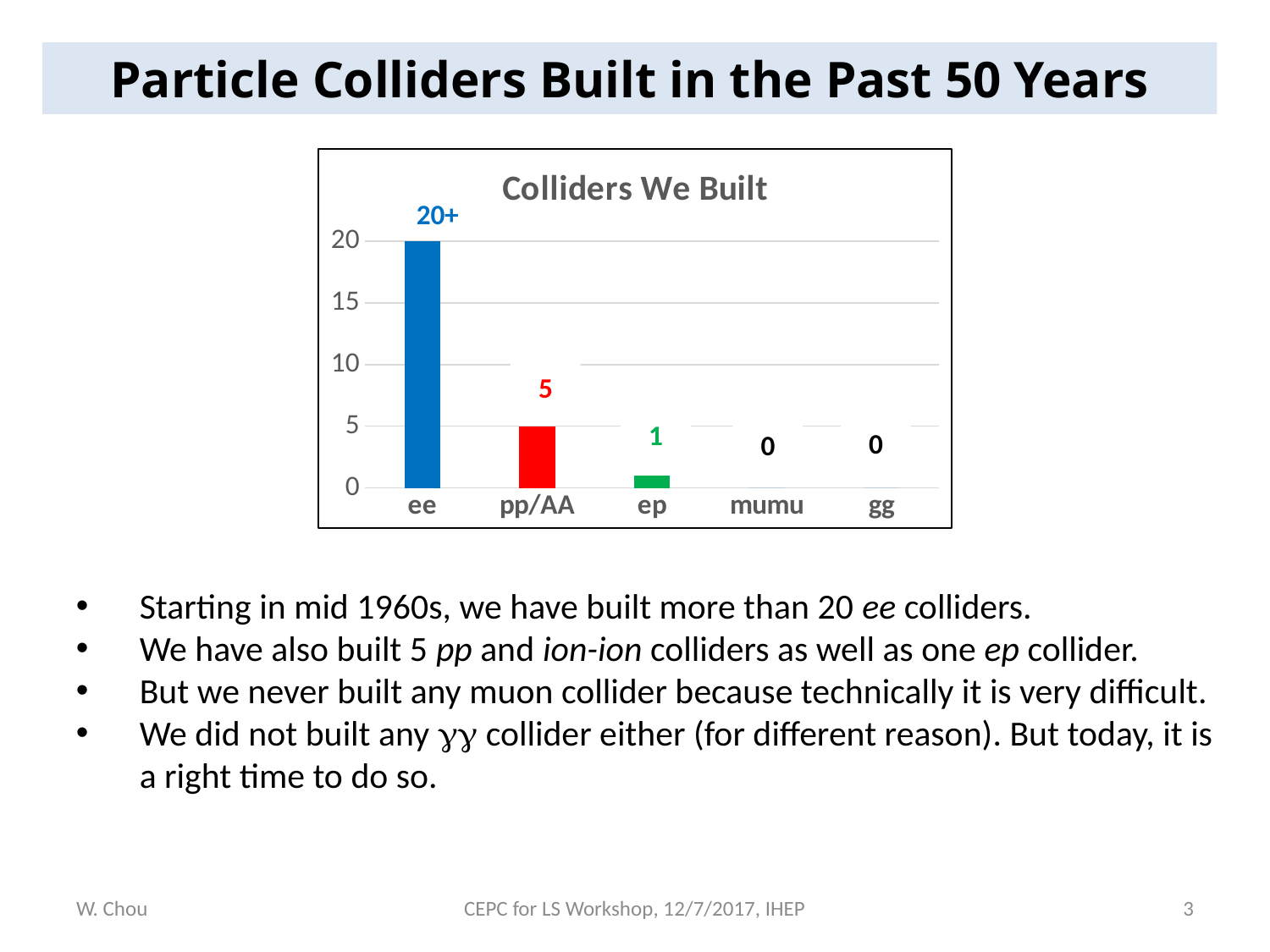
What colour is the pp/AA bar? red What is the title of the chart? Colliders We Built What is the difference between the values for pp/AA and ep? 4 What kind of chart is shown on the slide? bar chart Which category has the highest value? ee Which is larger, the value for pp/AA or the value for ep? pp/AA What is the value for ep? 1 What is the data label shown for the ee bar? 20+ How many categories are shown on the x axis of the chart? 5 What is the value for gg? 0 What is the value for pp/AA? 5 What is the value for mumu? 0